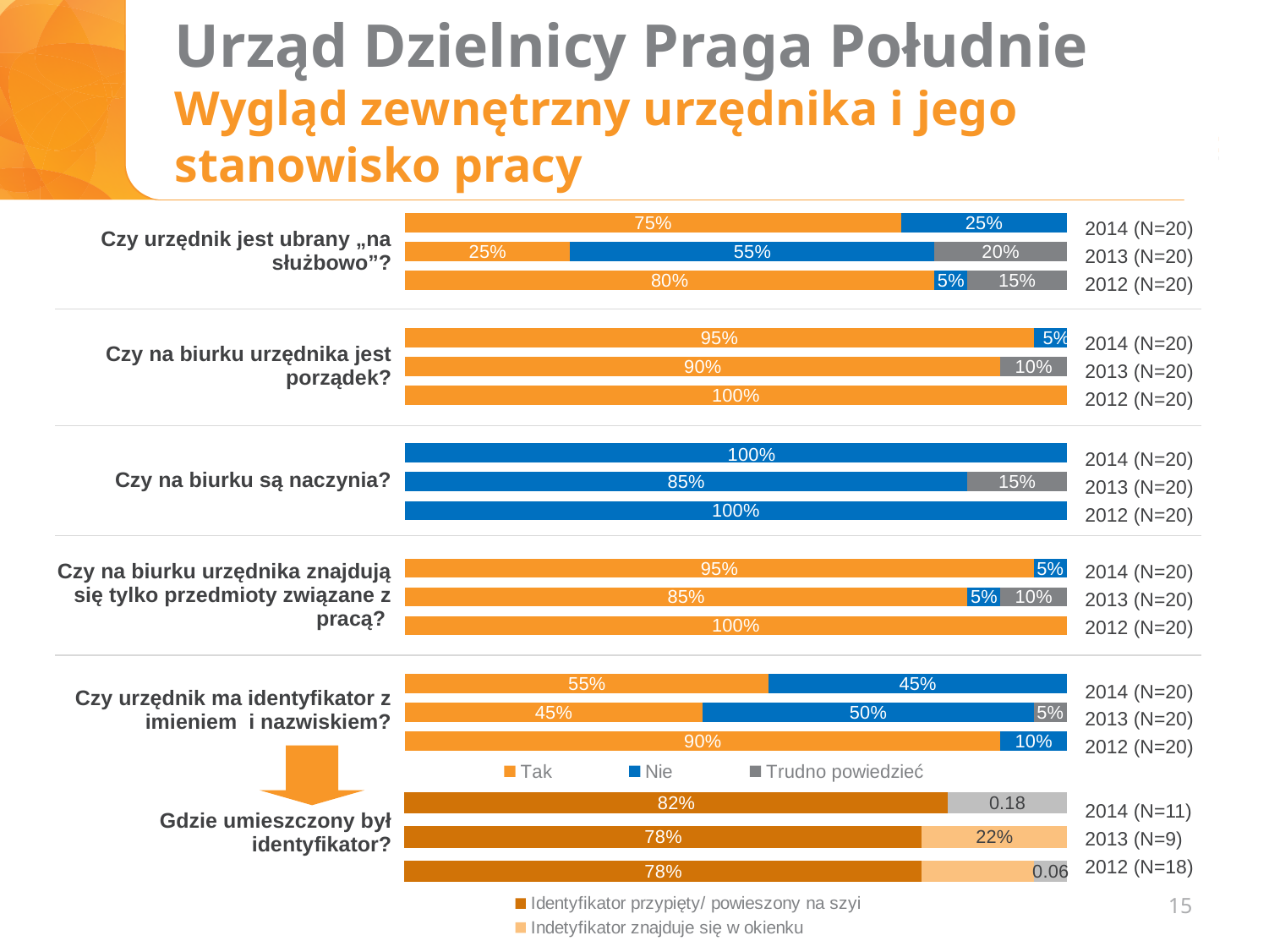
In the chart for "Czy na biurku urzędnika jest porządek?", what is the "Tak" value for 2013 (N=20)? 90% In the chart for "Czy na biurku urzędnika znajdują się tylko przedmioty związane z pracą?", what is the difference between the "Tak" values for 2014 (N=20) and 2013 (N=20)? 10% How many series does the legend with "Tak", "Nie" and "Trudno powiedzieć" list? 3 What type of chart is used for "Gdzie umieszczony był identyfikator?"? Stacked bar chart In the chart for "Czy urzędnik ma identyfikator z imieniem i nazwiskiem?", what is the "Tak" value for 2012 (N=20)? 90% In the chart for "Czy urzędnik ma identyfikator z imieniem i nazwiskiem?", which is larger for 2013 (N=20): "Tak" or "Nie"? Nie In the chart for "Czy urzędnik jest ubrany „na służbowo”?", which year has the highest "Tak" value? 2012 (N=20) In the chart for "Czy na biurku są naczynia?", what is the "Trudno powiedzieć" value for 2013 (N=20)? 15% In the chart for "Gdzie umieszczony był identyfikator?", what is the value for "Identyfikator przypięty/ powieszony na szyi" in 2014 (N=11)? 82% In the chart for "Czy urzędnik jest ubrany „na służbowo”?", what is the "Nie" value for 2013 (N=20)? 55% In the chart for "Czy urzędnik ma identyfikator z imieniem i nazwiskiem?", how does the "Tak" value change from 2012 to 2014? It falls In the chart for "Czy urzędnik jest ubrany „na służbowo”?", what is the "Tak" value for 2014 (N=20)? 75%